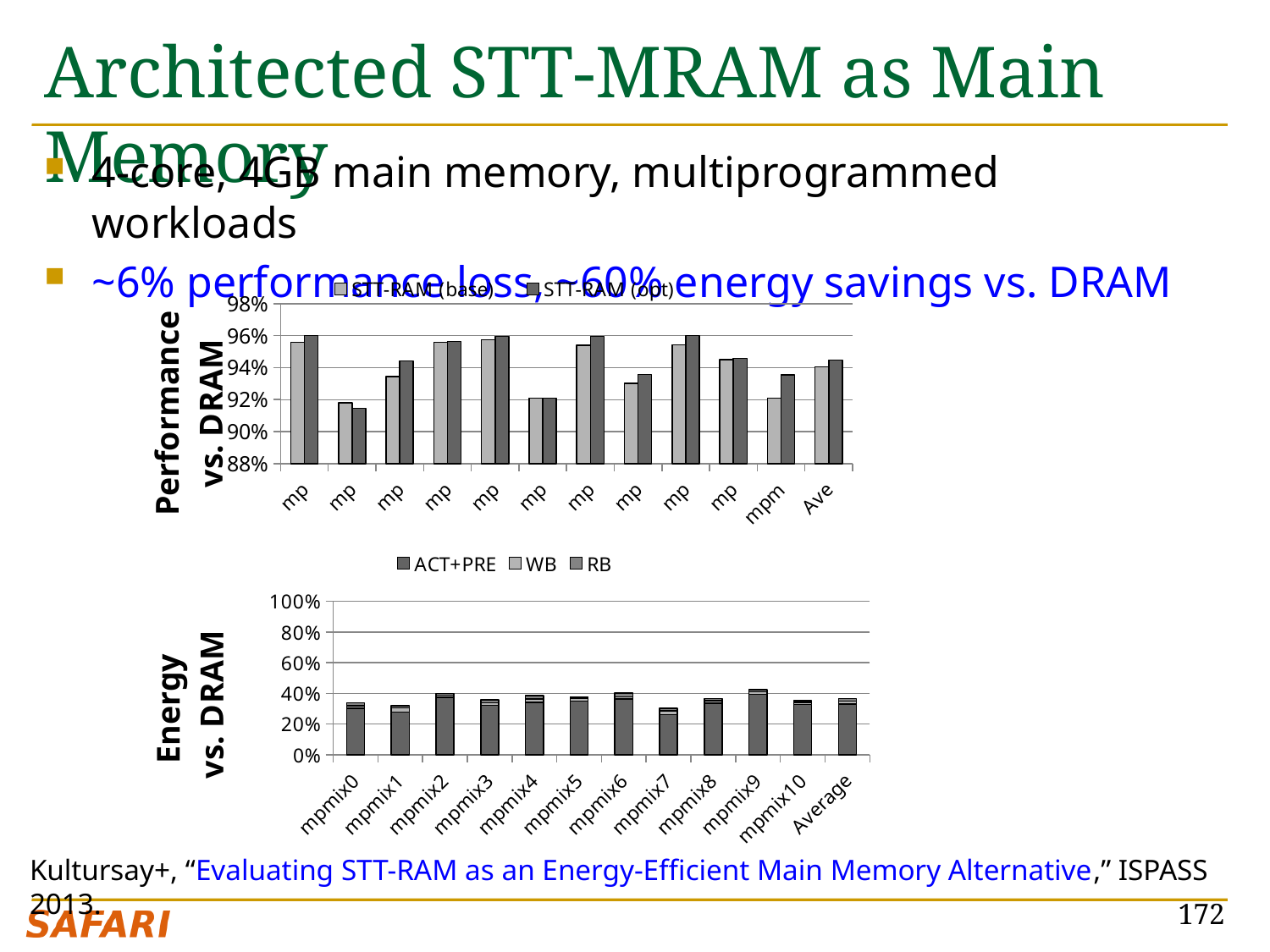
In the Energy vs. DRAM chart, is the total stacked value for mpmix2 greater or less than 20%? greater In the Performance vs. DRAM chart, is the STT-RAM (base) value for Ave greater or less than 92%? greater In the Energy vs. DRAM chart, which has the larger total stacked value, mpmix2 or mpmix1? mpmix2 How many series does the legend of the Performance vs. DRAM chart at the top of the slide list? 2 What kind of chart is the Energy vs. DRAM chart at the bottom of the slide? bar chart How many categories are shown on the x axis of the Energy vs. DRAM chart? 12 What are the three legend entries of the Energy vs. DRAM chart? ACT+PRE, WB, RB In the Energy vs. DRAM chart, which has the larger total stacked value, mpmix9 or mpmix7? mpmix9 In the Energy vs. DRAM chart, is the total stacked value for mpmix7 greater or less than 40%? less How many series does the legend of the Energy vs. DRAM chart list? 3